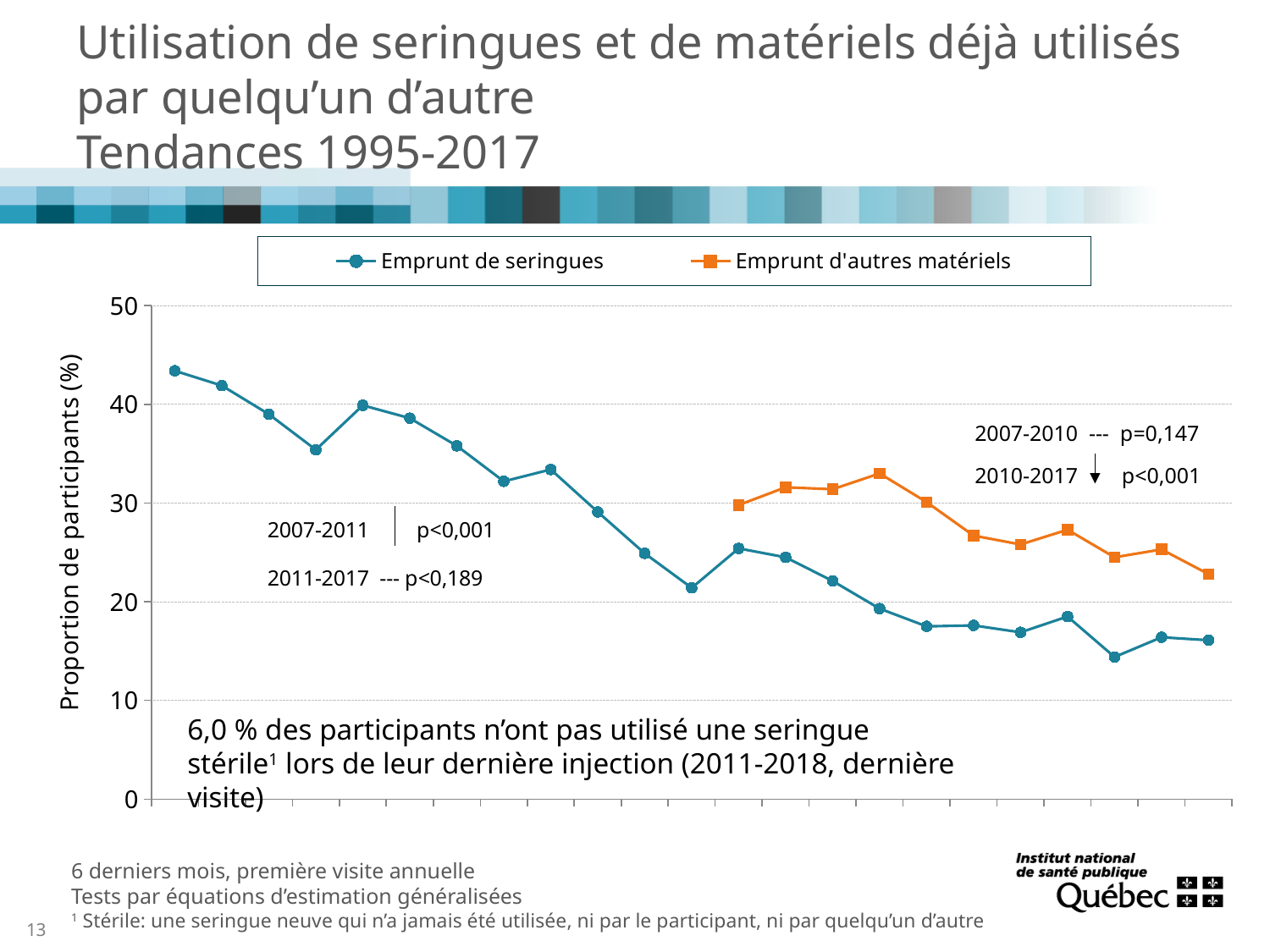
Is the last plotted value of the Emprunt d'autres matériels series greater or less than 20? greater What kind of chart is shown on the slide? line chart Is the last plotted value of the Emprunt de seringues series greater or less than 20? less How many data points are plotted for the Emprunt d'autres matériels series? 11 Does the Emprunt d'autres matériels series generally rise or fall from left to right? fall What is the label of the vertical axis? Proportion de participants (%) Is the highest value of the Emprunt d'autres matériels series greater or less than 30? greater How many series does the legend list? 2 At the right end of the chart, which series has the higher value, Emprunt de seringues or Emprunt d'autres matériels? Emprunt d'autres matériels What are the two series named in the legend? Emprunt de seringues; Emprunt d'autres matériels Does the Emprunt de seringues series generally rise or fall from left to right? fall